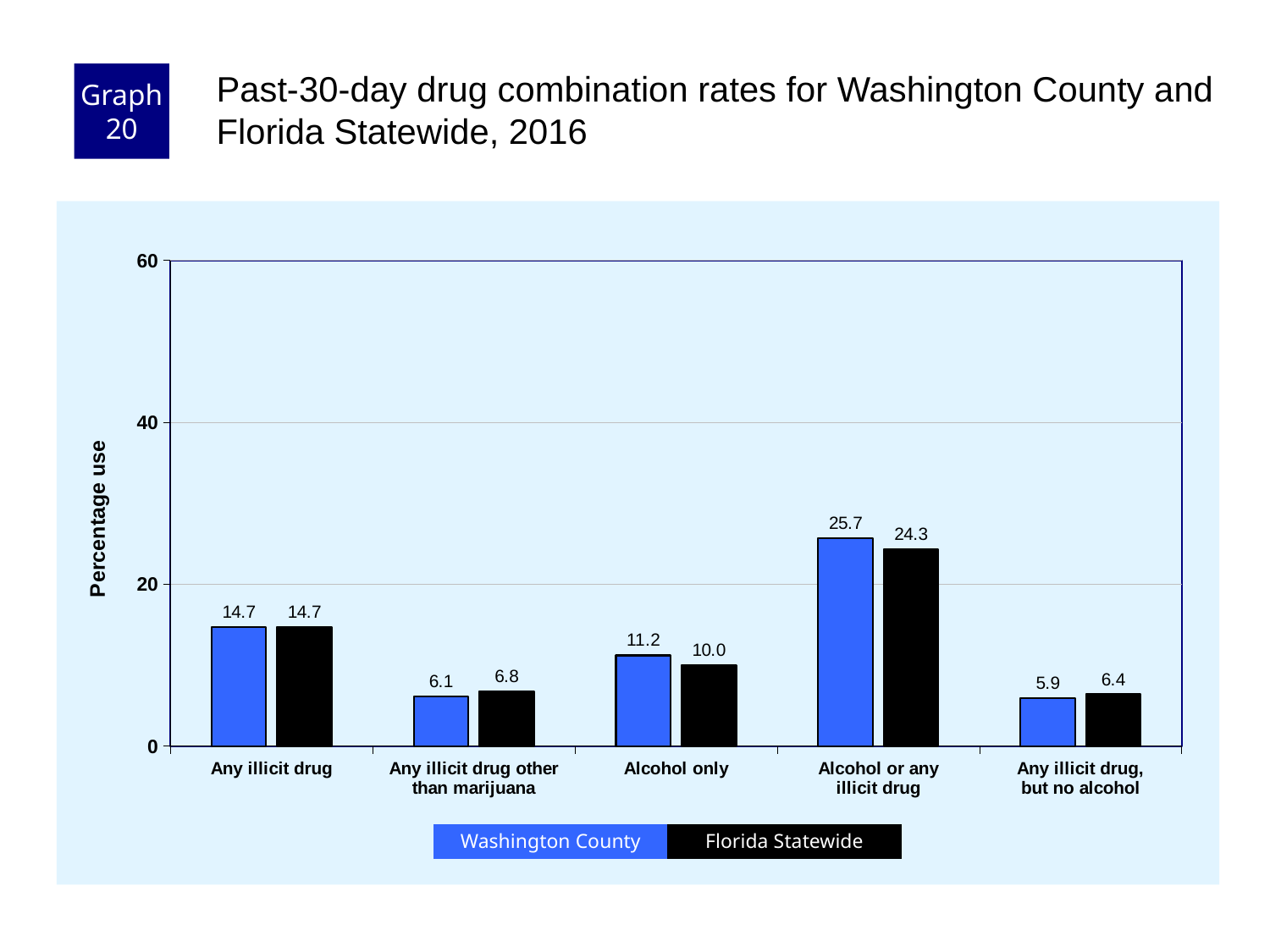
Which category has the highest Washington County value? Alcohol or any illicit drug What is the Washington County value for Any illicit drug, but no alcohol? 5.9 Which is larger for Any illicit drug other than marijuana: Washington County or Florida Statewide? Florida Statewide What is the Florida Statewide value for Alcohol or any illicit drug? 24.3 Is the Washington County value for Alcohol or any illicit drug greater or less than 20? greater How many categories are shown on the x axis? 5 What is the difference between the Washington County and Florida Statewide values for Alcohol or any illicit drug? 1.4 What is the label of the y axis? Percentage use What is the Washington County value for Alcohol only? 11.2 Which category has the lowest Florida Statewide value? Any illicit drug, but no alcohol What kind of chart is shown? bar chart How many series does the legend list? 2